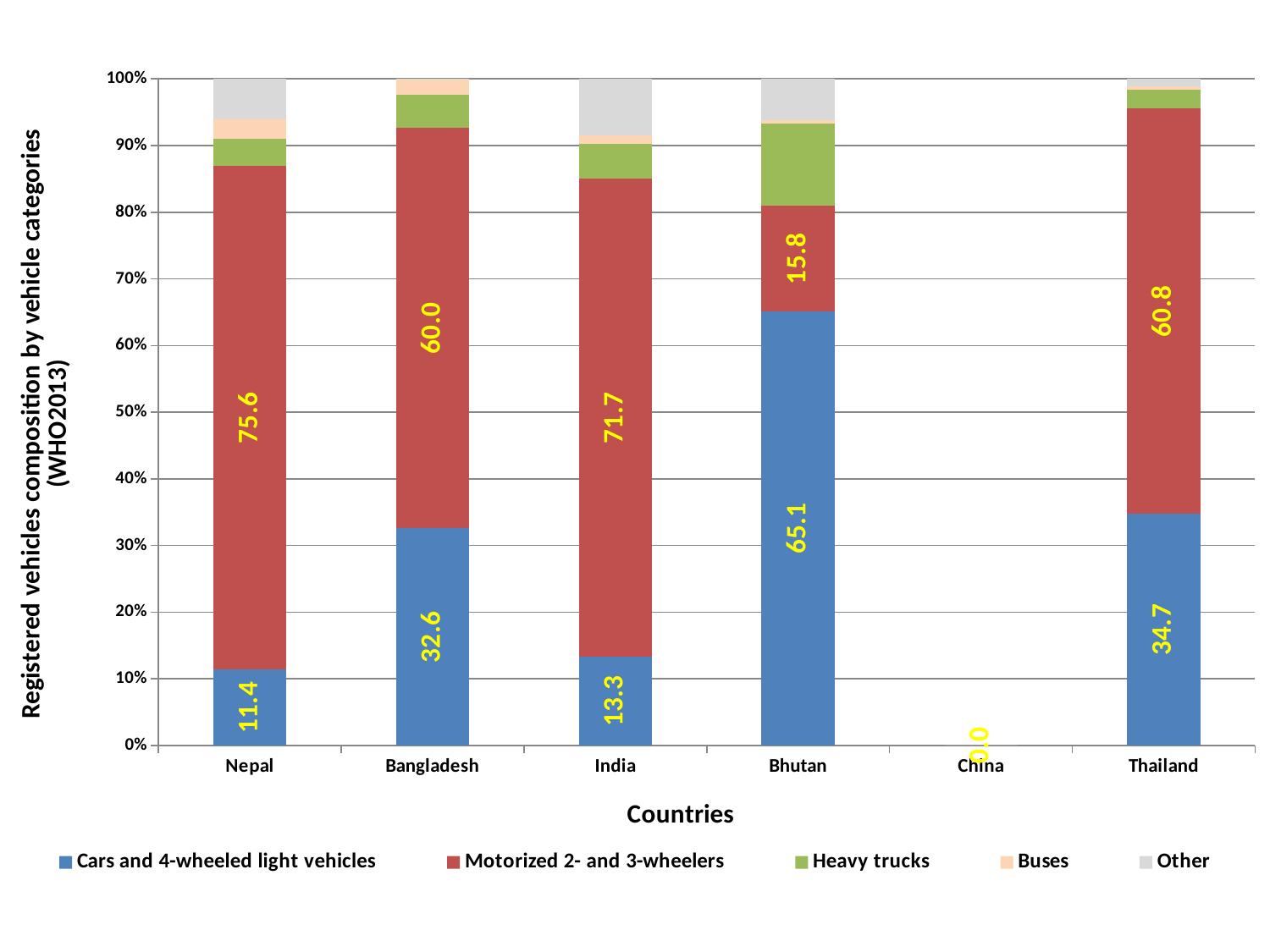
What is the value for Cars and 4-wheeled light vehicles in India? 13.3 Is the Cars and 4-wheeled light vehicles value for Thailand greater or less than 30%? greater How many series does the legend list? 5 What is the value for Cars and 4-wheeled light vehicles in Bhutan? 65.1 What is the value for Motorized 2- and 3-wheelers in Nepal? 75.6 What is the difference between the Cars and 4-wheeled light vehicles values for Bangladesh and Nepal? 21.2 Which country has the highest value for Cars and 4-wheeled light vehicles? Bhutan How many countries are shown on the x axis? 6 What kind of chart is this? Stacked bar chart Among the countries with labelled values, which has the lowest value for Motorized 2- and 3-wheelers? China What is the value for Motorized 2- and 3-wheelers in Thailand? 60.8 Which is larger: the Motorized 2- and 3-wheelers value for India or for Bangladesh? India